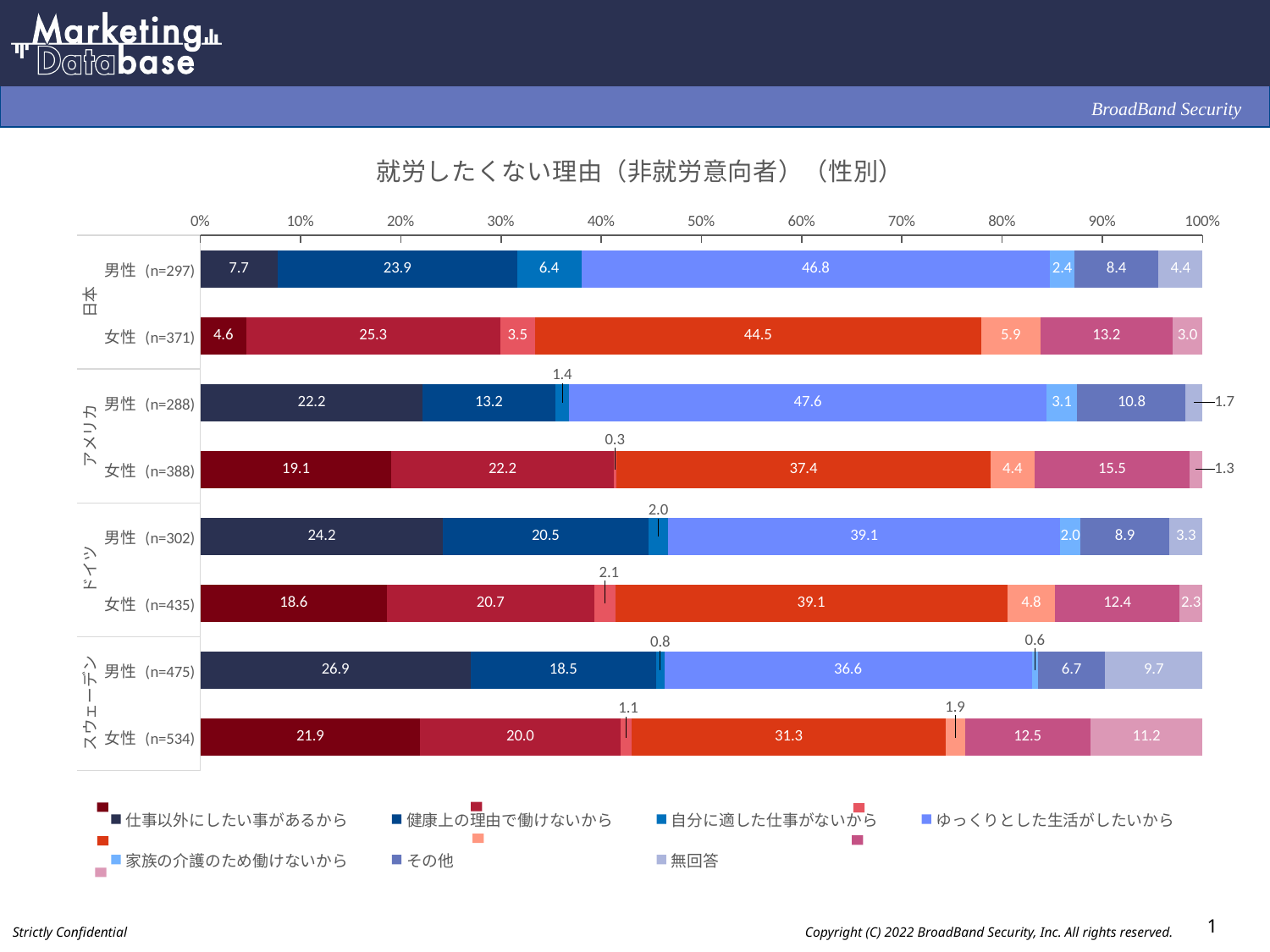
What type of chart is shown on the slide? Stacked bar chart What is the value of 無回答 for スウェーデン 女性 (n=534)? 11.2 Which group has the lowest value for 仕事以外にしたい事があるから? 日本 女性 (n=371) Which group has the highest value for ゆっくりとした生活がしたいから? アメリカ 男性 (n=288) What is the value of 健康上の理由で働けないから for 日本 女性 (n=371)? 25.3 What is the title of the chart? 就労したくない理由（非就労意向者）（性別） How many bars (respondent groups) are plotted in the chart? 8 What is the value of ゆっくりとした生活がしたいから for 日本 男性 (n=297)? 46.8 What is the value of 仕事以外にしたい事があるから for スウェーデン 男性 (n=475)? 26.9 What is the difference between the ゆっくりとした生活がしたいから values for アメリカ 男性 (n=288) and アメリカ 女性 (n=388)? 10.2 Which is larger: the その他 value for アメリカ 女性 (n=388) or for ドイツ 女性 (n=435)? アメリカ 女性 (n=388) How many series does the legend list? 7